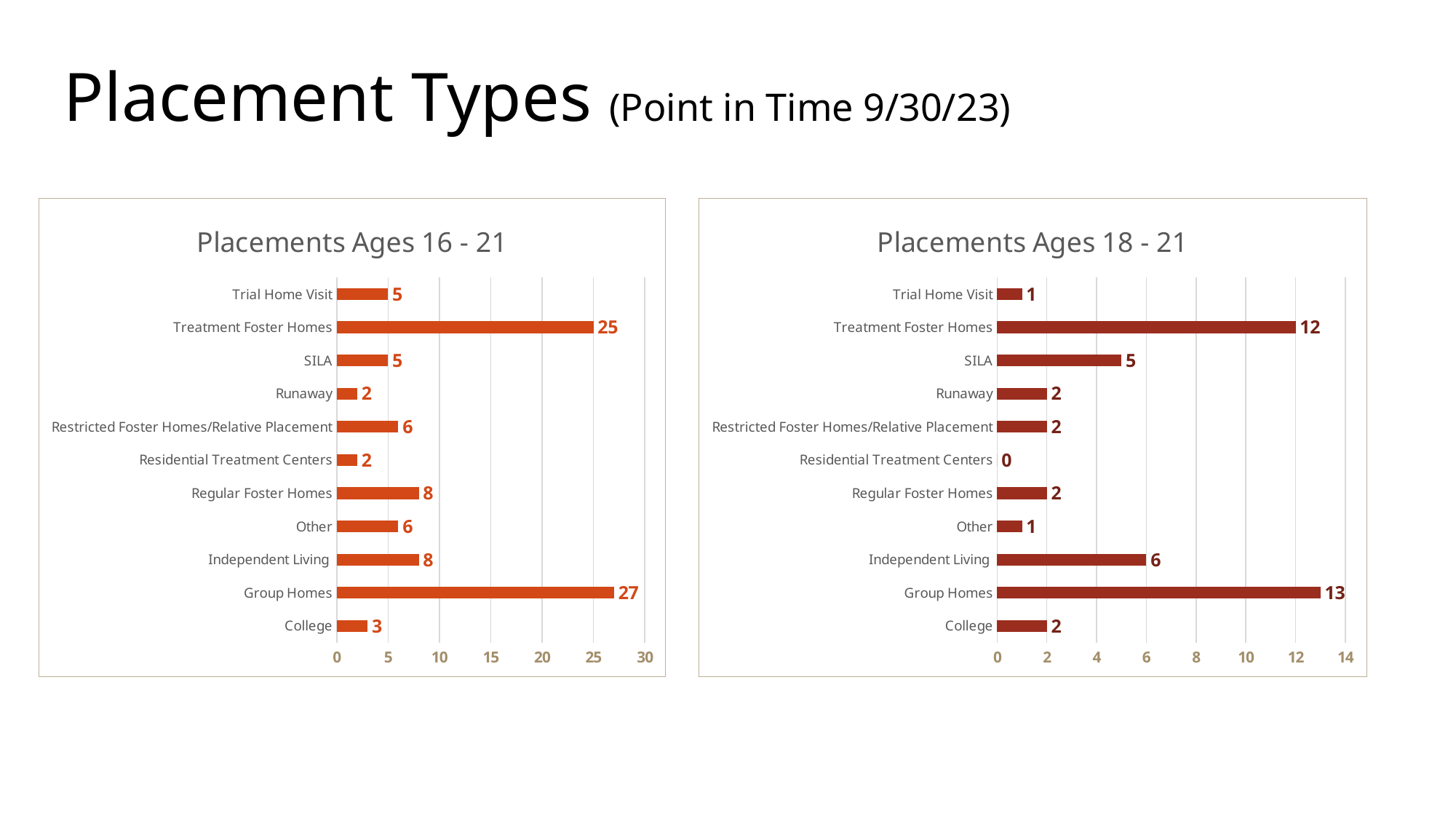
In the 'Placements Ages 16 - 21' chart, which category has the highest value? Group Homes In the 'Placements Ages 18 - 21' chart, what is the value for Group Homes? 13 In the 'Placements Ages 18 - 21' chart, what is the difference between Treatment Foster Homes and Independent Living? 6 In the 'Placements Ages 16 - 21' chart, what is the difference between Group Homes and Treatment Foster Homes? 2 In the 'Placements Ages 16 - 21' chart, what is the value for Treatment Foster Homes? 25 In the 'Placements Ages 18 - 21' chart, is the value for SILA greater or less than 4? greater How many categories are shown in the 'Placements Ages 16 - 21' chart? 11 What is the title of the chart on the left side of the slide? Placements Ages 16 - 21 What kind of chart is the 'Placements Ages 18 - 21' chart? Bar chart In the 'Placements Ages 18 - 21' chart, which category has the lowest value? Residential Treatment Centers In the 'Placements Ages 18 - 21' chart, what is the value for Residential Treatment Centers? 0 In the 'Placements Ages 16 - 21' chart, which is larger: Regular Foster Homes or Other? Regular Foster Homes